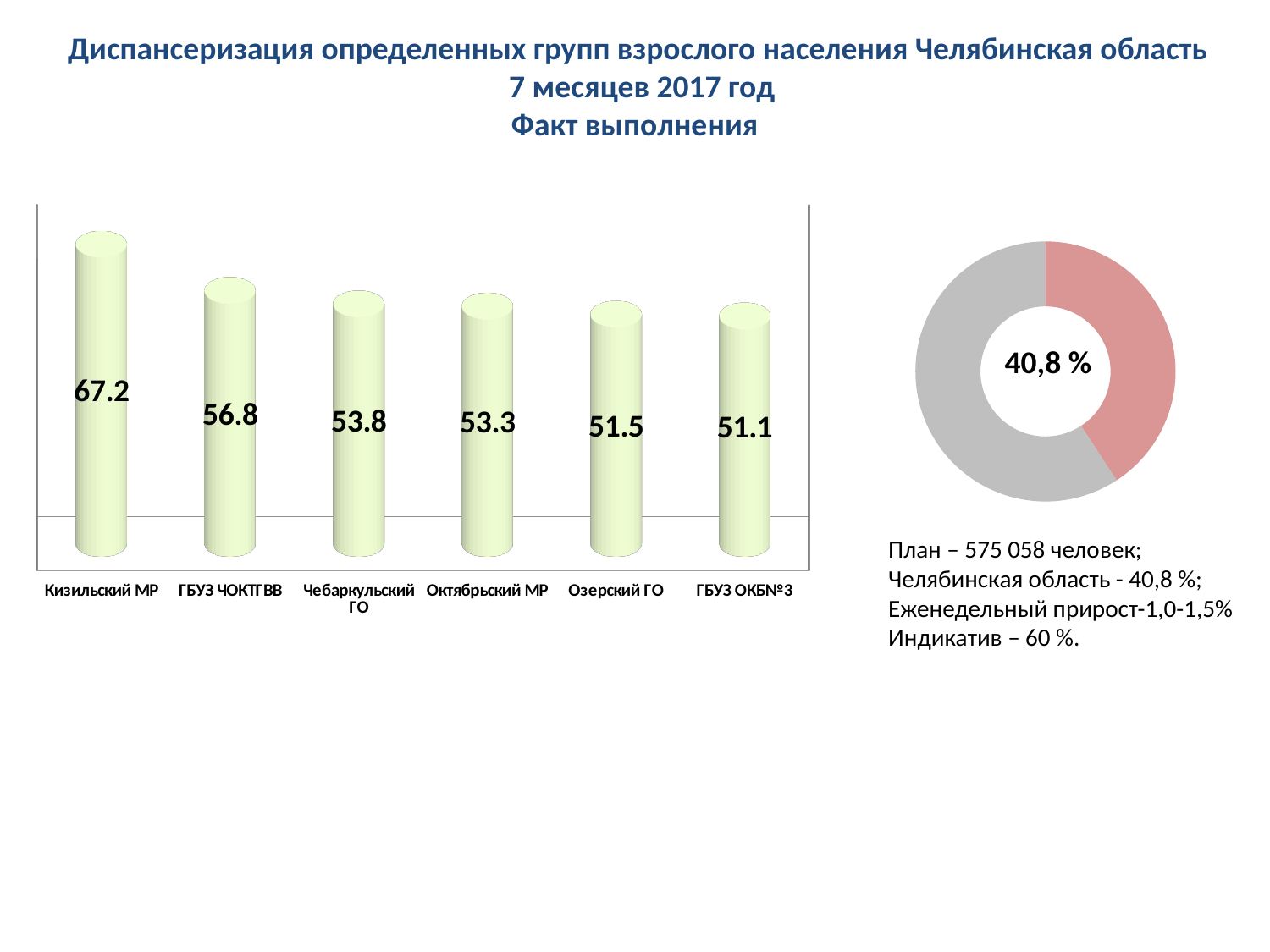
How many categories are shown in the bar chart on the left? 6 In the bar chart on the left, which category has the lowest value? ГБУЗ ОКБ№3 In the bar chart on the left, what is the difference between the values for Чебаркульский ГО and Октябрьский МР? 0.5 In the bar chart on the left, what is the value for Озерский ГО? 51.5 In the donut chart on the right, what share is shown for the red slice? 40,8 % In the bar chart on the left, what is the value for Кизильский МР? 67.2 In the bar chart on the left, what is the value for ГБУЗ ЧОКТГВВ? 56.8 In the bar chart on the left, what is the difference between the values for Кизильский МР and ГБУЗ ЧОКТГВВ? 10.4 In the bar chart on the left, which category has the highest value? Кизильский МР What kind of chart is the chart on the left of the slide? Bar chart In the bar chart on the left, do the values rise or fall from left to right? Fall In the bar chart on the left, which is larger: the value for Октябрьский МР or the value for Озерский ГО? Октябрьский МР